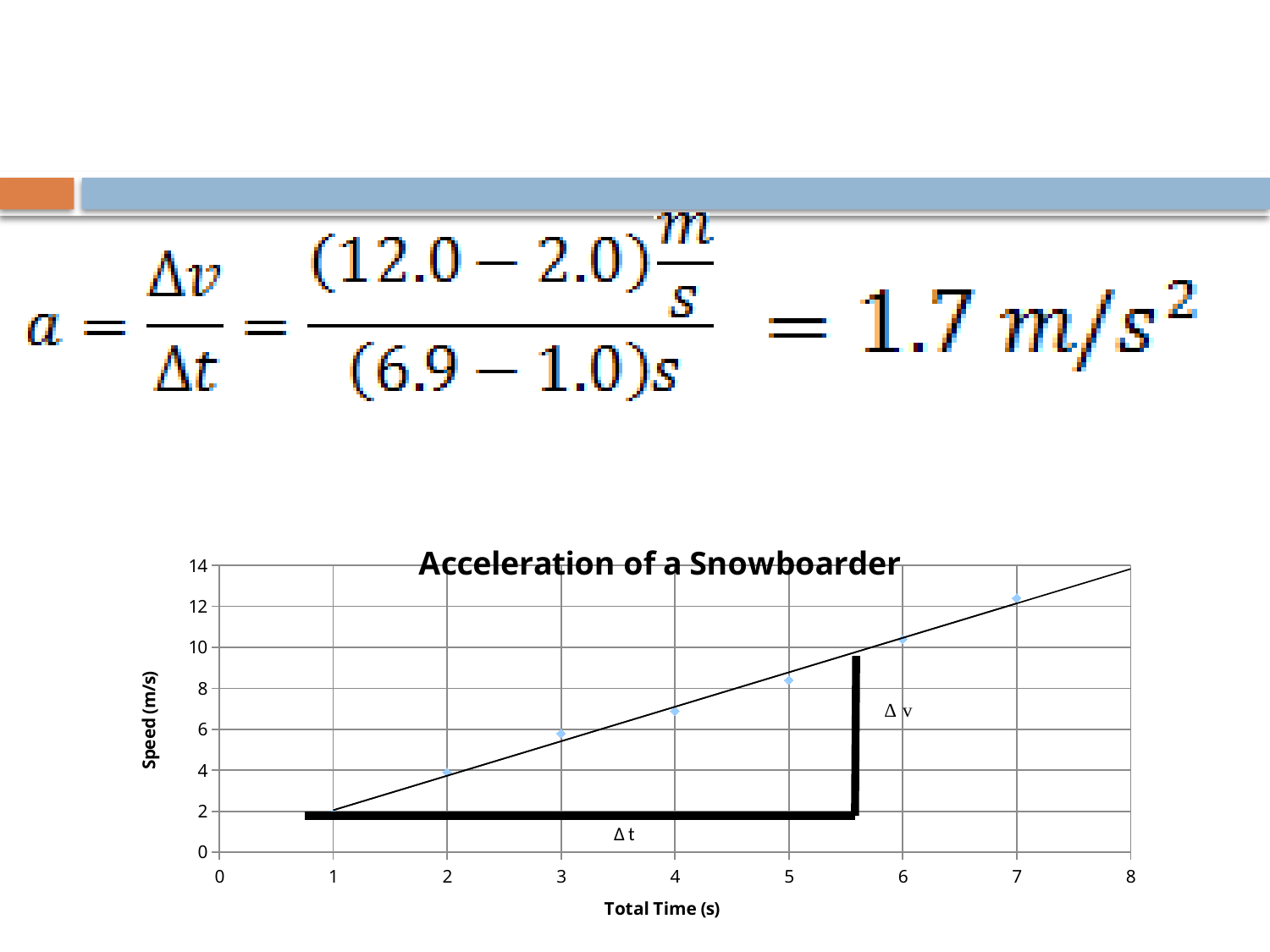
Is the speed at a total time of 4 s greater or less than 8 m/s? less Which is larger, the speed at 6 s or the speed at 3 s? 6 s At which total time is the plotted speed highest? 7 Do the plotted speed values rise or fall as total time increases? rise What kind of chart is shown on the slide? scatter plot How many data points are plotted on the chart? 7 What is the title of the chart? Acceleration of a Snowboarder Is the speed at a total time of 7 s greater or less than 12 m/s? greater Is the speed at a total time of 5 s greater or less than 8 m/s? greater What is the label of the vertical axis? Speed (m/s) At which total time is the plotted speed lowest? 1